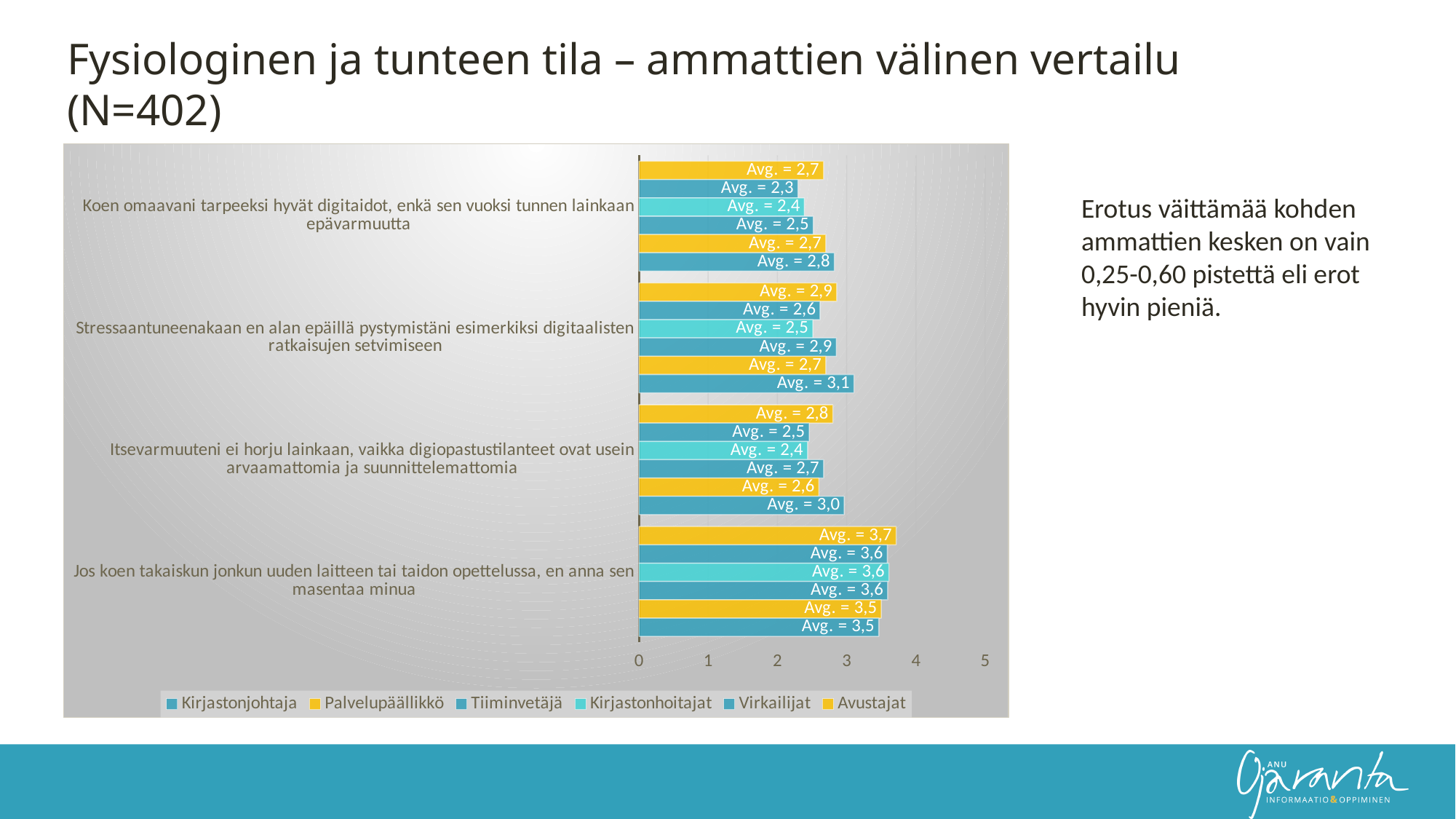
How many series does the legend list? 6 What is the highest average value shown for the statement 'Stressaantuneenakaan en alan epäillä pystymistäni esimerkiksi digitaalisten ratkaisujen setvimiseen'? 3,1 For Kirjastonhoitajat, which statement has the larger average: 'Stressaantuneenakaan en alan epäillä pystymistäni...' or 'Jos koen takaiskun jonkun uuden laitteen tai taidon opettelussa...'? Jos koen takaiskun jonkun uuden laitteen tai taidon opettelussa, en anna sen masentaa minua How many statement categories are plotted on the y axis? 4 What is the first entry in the chart legend? Kirjastonjohtaja What is the lowest average value shown for the statement 'Koen omaavani tarpeeksi hyvät digitaidot, enkä sen vuoksi tunnen lainkaan epävarmuutta'? 2,3 What type of chart is shown on the slide? bar chart Is the value for Kirjastonhoitajat for the statement 'Jos koen takaiskun jonkun uuden laitteen tai taidon opettelussa, en anna sen masentaa minua' greater or less than 3? greater What is the average value for Kirjastonhoitajat for the statement 'Jos koen takaiskun jonkun uuden laitteen tai taidon opettelussa, en anna sen masentaa minua'? 3,6 For the statement 'Itsevarmuuteni ei horju lainkaan, vaikka digiopastustilanteet ovat usein arvaamattomia ja suunnittelemattomia', what is the difference between the highest and lowest average values? 0,6 What is the average value for Kirjastonhoitajat for the statement 'Koen omaavani tarpeeksi hyvät digitaidot, enkä sen vuoksi tunnen lainkaan epävarmuutta'? 2,4 What is the maximum value shown on the x axis? 5